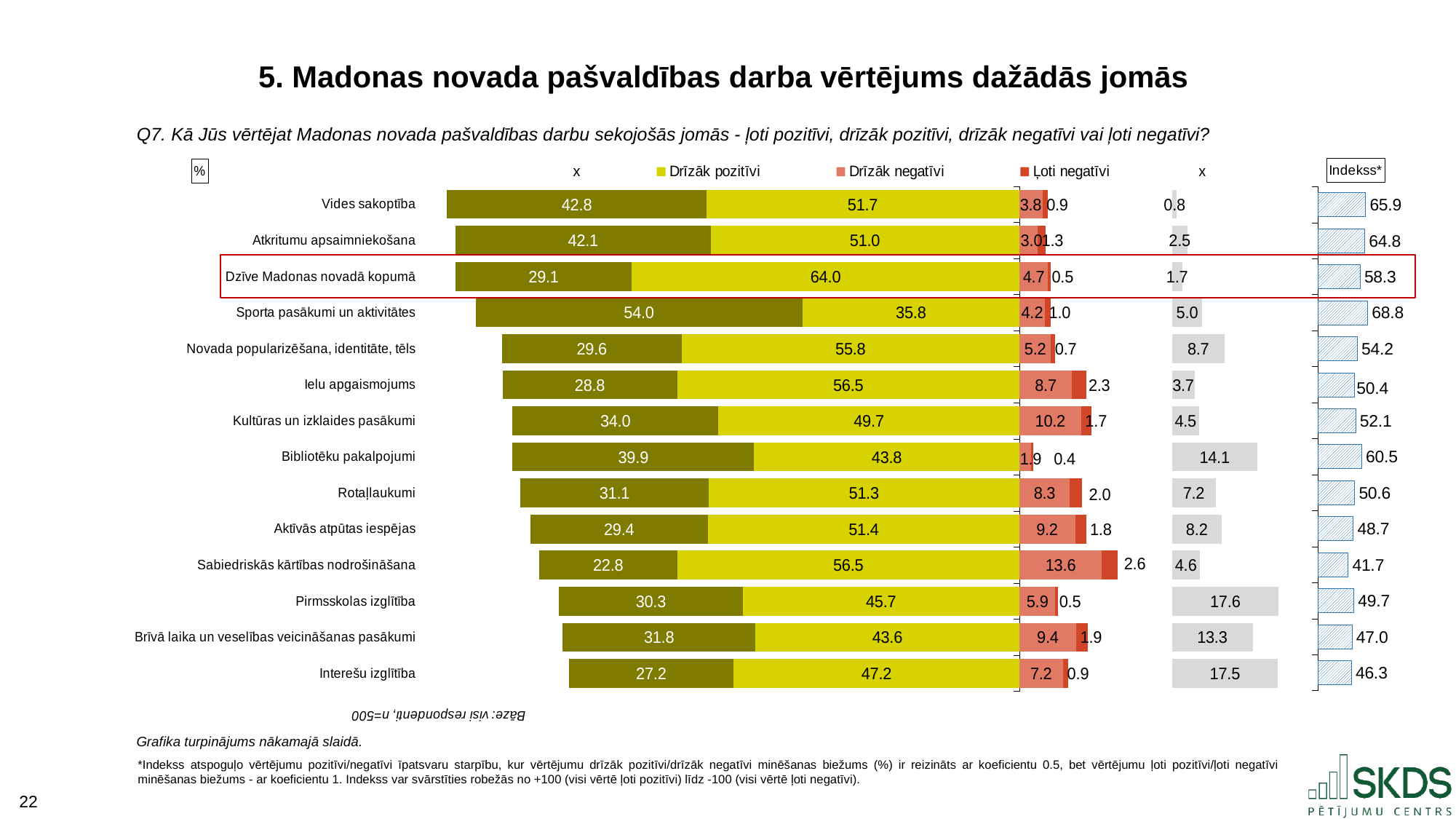
What is the "Ļoti negatīvi" value for "Sabiedriskās kārtības nodrošināšana"? 2.6 How many categories (rows) are shown in the chart? 14 Which category has the highest "Drīzāk pozitīvi" value? Dzīve Madonas novadā kopumā What is the Indekss* value for "Sporta pasākumi un aktivitātes"? 68.8 Which has a larger "Drīzāk negatīvi" value: "Kultūras un izklaides pasākumi" or "Ielu apgaismojums"? Kultūras un izklaides pasākumi Which category is highlighted with a red box on the chart? Dzīve Madonas novadā kopumā Which category has the highest Indekss* value? Sporta pasākumi un aktivitātes Which category has the lowest Indekss* value? Sabiedriskās kārtības nodrošināšana What is the "Drīzāk pozitīvi" value for "Dzīve Madonas novadā kopumā"? 64.0 What is the "Drīzāk negatīvi" value for "Sabiedriskās kārtības nodrošināšana"? 13.6 Which category has the lowest "Drīzāk negatīvi" value? Bibliotēku pakalpojumi What is the difference between the Indekss* values of "Vides sakoptība" and "Atkritumu apsaimniekošana"? 1.1